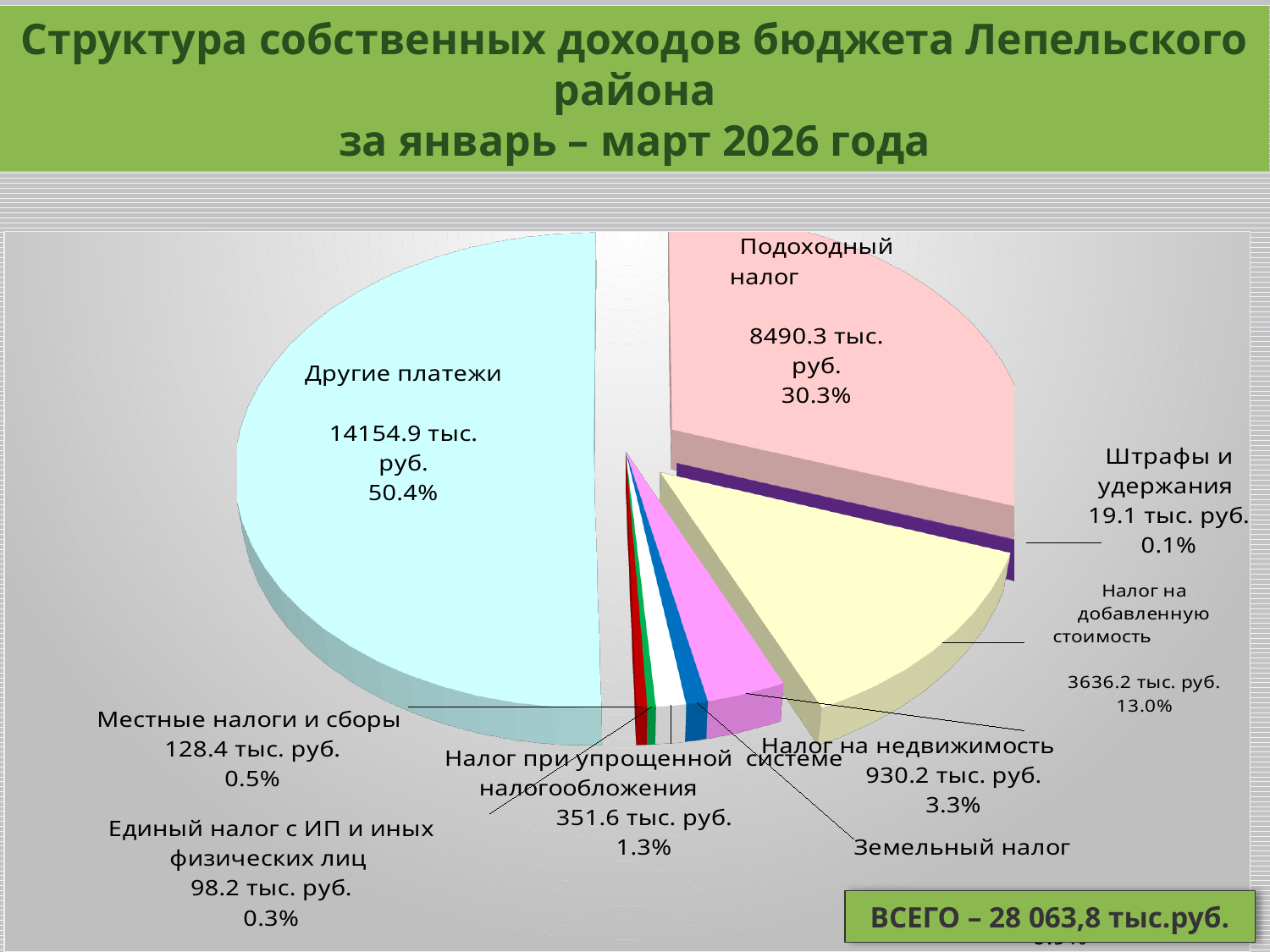
What is the value for Налог на недвижимость? 930.2 тыс. руб. What total amount (ВСЕГО) is stated on the slide? 28 063,8 тыс.руб. Which category has the largest share of the pie? Другие платежи What share of the pie does Другие платежи represent? 50.4% What type of chart is shown on the slide? pie chart What share of the pie does Налог при упрощенной системе налогообложения represent? 1.3% What is the value for Единый налог с ИП и иных физических лиц? 98.2 тыс. руб. What is the difference between the values for Другие платежи and Подоходный налог? 5664.6 тыс. руб. What is the value for Подоходный налог? 8490.3 тыс. руб. What is the value for Налог на добавленную стоимость? 3636.2 тыс. руб. Which category has the smallest share of the pie? Штрафы и удержания Which is larger: Местные налоги и сборы or Налог на недвижимость? Налог на недвижимость